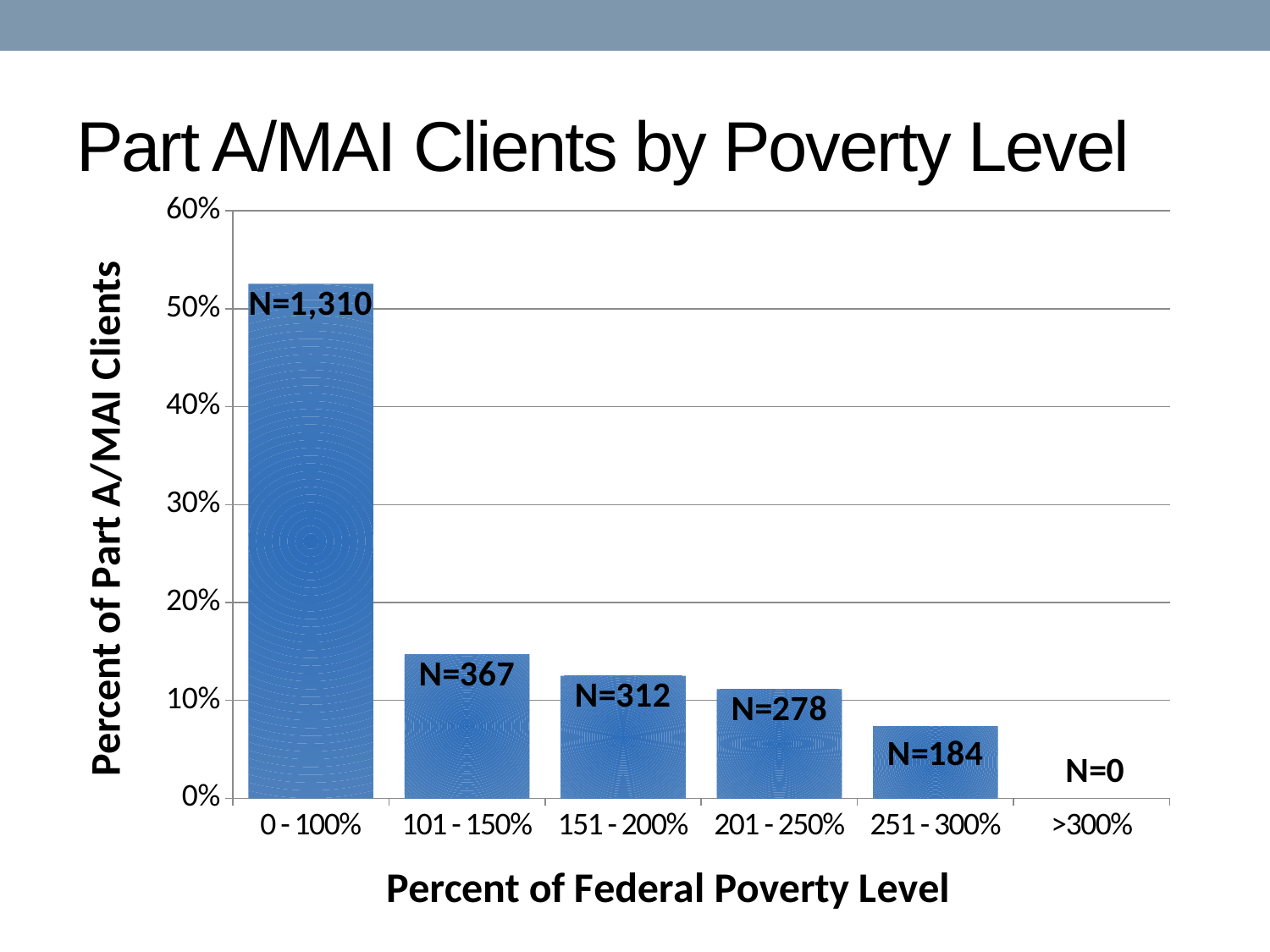
What is the N label shown for the >300% poverty level category? N=0 What is the N label shown for the 251 - 300% poverty level category? N=184 Which poverty level category has the highest percent of Part A/MAI clients? 0 - 100% Which category has a larger percent of Part A/MAI clients, 101 - 150% or 201 - 250%? 101 - 150% How many poverty level categories are shown on the x axis? 6 What is the N label shown on the bar for the 0 - 100% poverty level category? N=1,310 Do the percentages rise or fall as the poverty level categories increase along the x axis? fall What kind of chart is shown on the slide? bar chart Is the percent of Part A/MAI clients for the 251 - 300% category greater or less than 10%? less Is the percent of Part A/MAI clients for the 0 - 100% category greater or less than 50%? greater What is the title of the chart? Part A/MAI Clients by Poverty Level Which poverty level category has the lowest percent of Part A/MAI clients? >300%